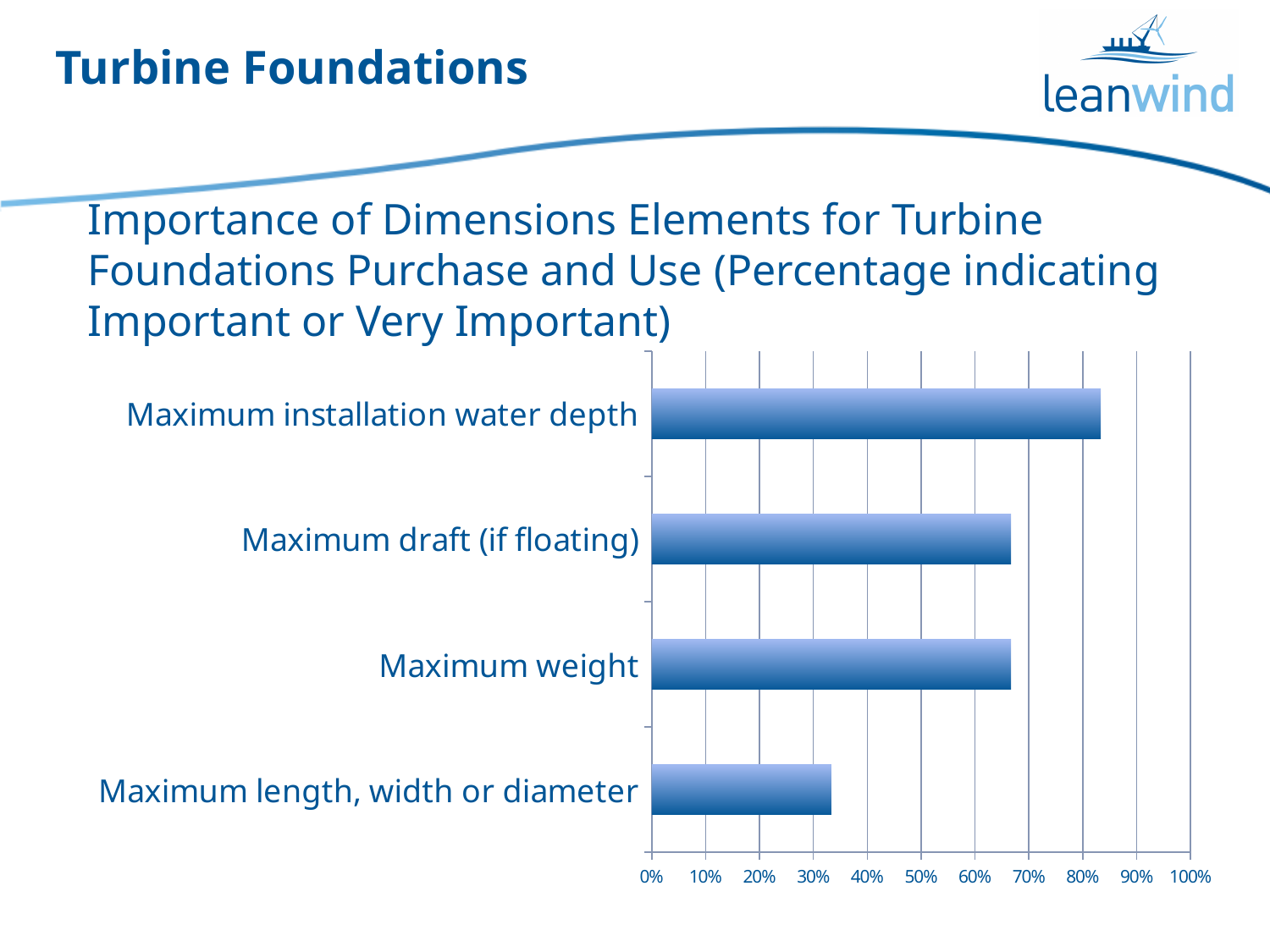
Is the value for Maximum length, width or diameter greater or less than 40%? less Which is larger, the value for Maximum installation water depth or the value for Maximum draft (if floating)? Maximum installation water depth How many categories are plotted in the chart? 4 What kind of chart is shown on the slide? bar chart What is the title of the chart? Importance of Dimensions Elements for Turbine Foundations Purchase and Use (Percentage indicating Important or Very Important) Is the value for Maximum weight greater or less than 60%? greater Is the value for Maximum draft (if floating) greater or less than 70%? less Which is larger, the value for Maximum weight or the value for Maximum length, width or diameter? Maximum weight What is the highest value shown on the horizontal axis of the chart? 100% Which category has the lowest value? Maximum length, width or diameter Which category has the highest value? Maximum installation water depth